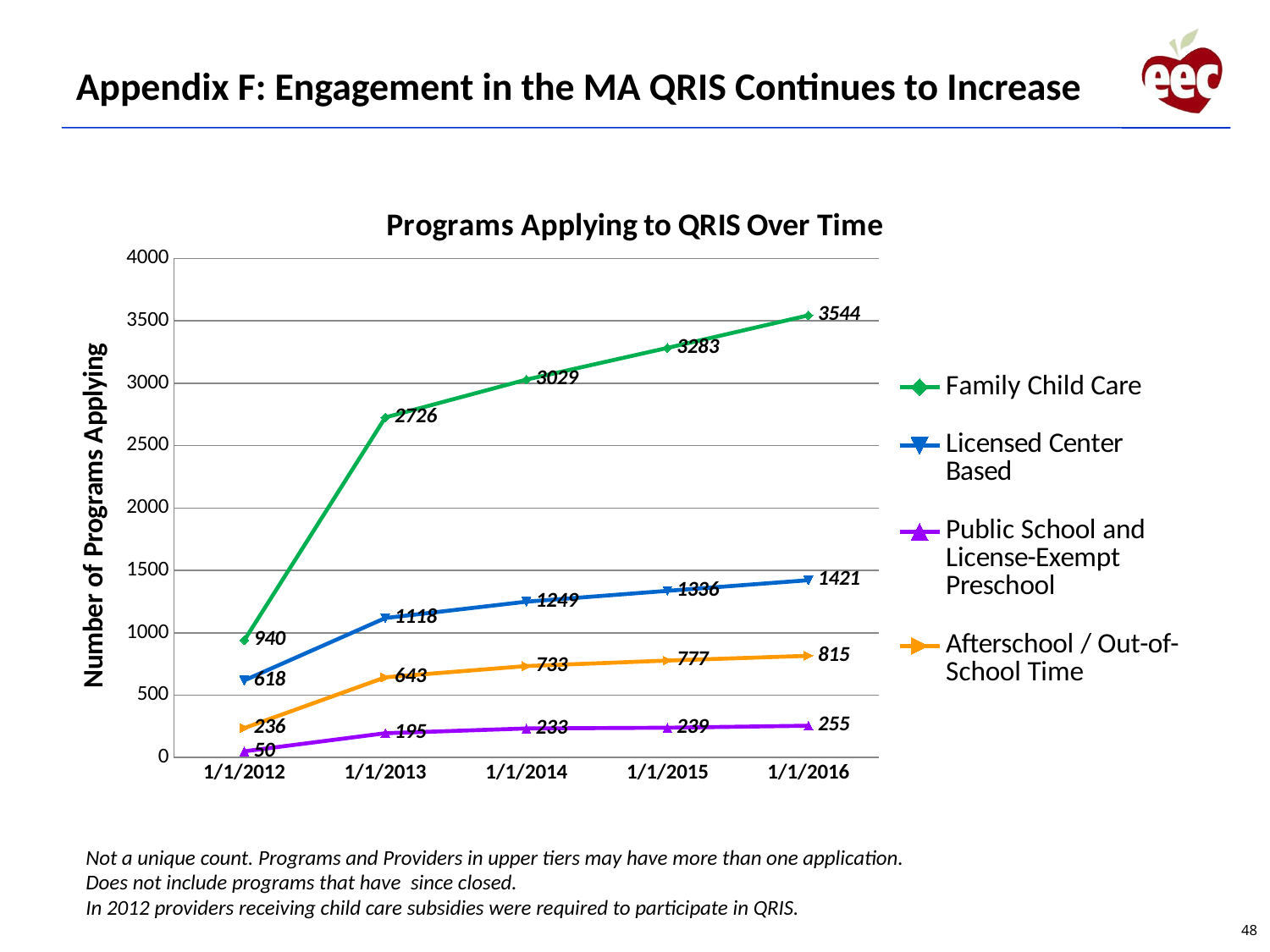
What is the value for Family Child Care on 1/1/2016? 3544 Do the Licensed Center Based values rise or fall from 1/1/2012 to 1/1/2016? Rise Which series has the highest value on 1/1/2016? Family Child Care How many series does the legend list? 4 What is the difference between the Family Child Care values on 1/1/2013 and 1/1/2012? 1786 Which is larger: Licensed Center Based on 1/1/2014 or Afterschool / Out-of-School Time on 1/1/2016? Licensed Center Based on 1/1/2014 How many dates are shown on the x axis? 5 What kind of chart is this? Line chart Which series has the lowest value on 1/1/2012? Public School and License-Exempt Preschool What is the value for Public School and License-Exempt Preschool on 1/1/2015? 239 What is the value for Licensed Center Based on 1/1/2013? 1118 What is the value for Afterschool / Out-of-School Time on 1/1/2012? 236